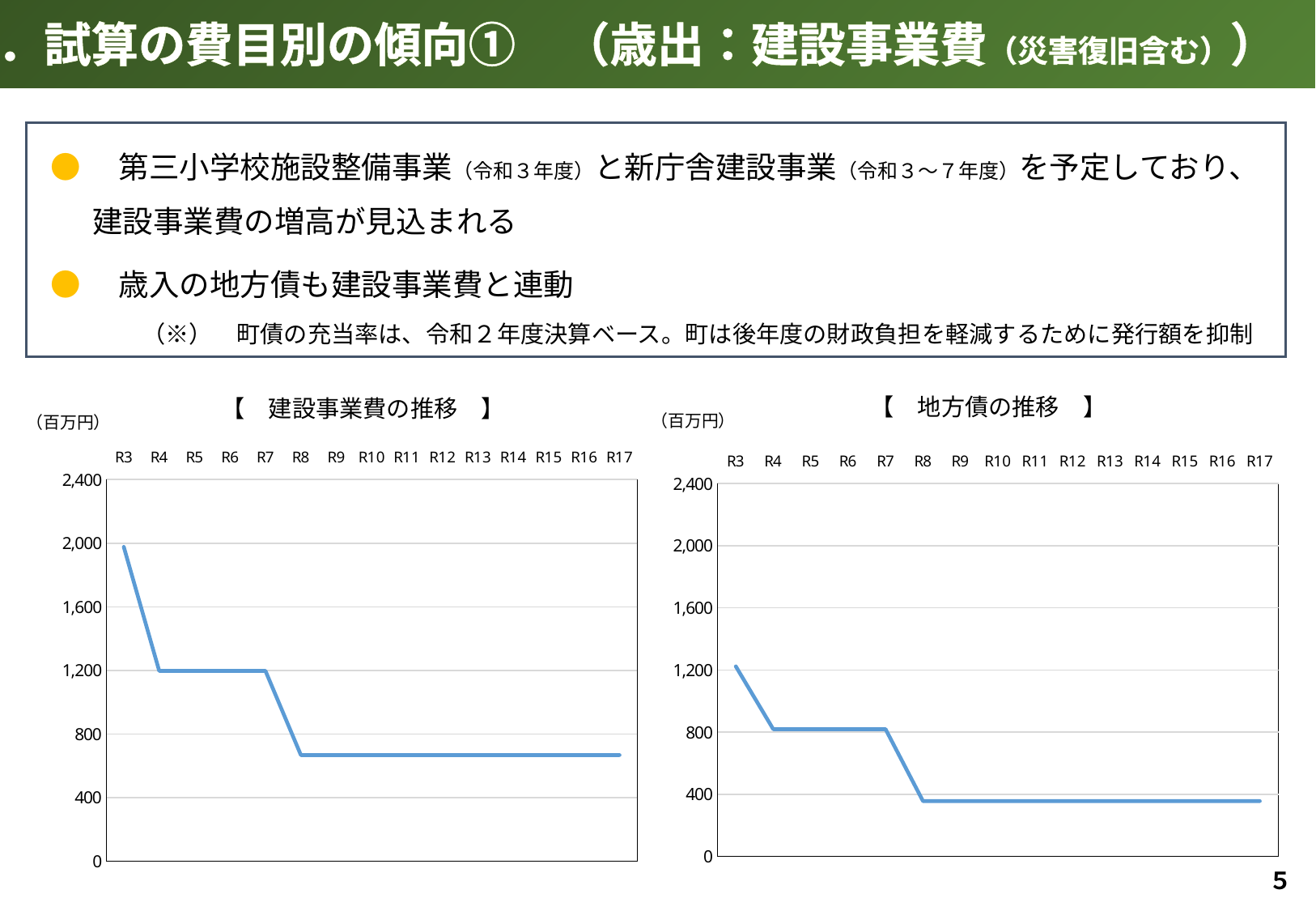
In the chart titled 地方債の推移, is the value for R3 greater or less than 800? greater What kind of chart is the chart titled 地方債の推移? line chart In the chart titled 建設事業費の推移, is the value for R5 greater or less than 800? greater In the chart titled 建設事業費の推移, is the value for R3 greater or less than 1,600? greater How many years are plotted on the x axis of the chart titled 建設事業費の推移? 15 In the chart titled 建設事業費の推移, which year has the highest value? R3 In the chart titled 地方債の推移, which is larger, the value for R6 or the value for R15? R6 In the chart titled 建設事業費の推移, do the values generally rise or fall from R3 to R17? fall In the chart titled 地方債の推移, which year has the highest value? R3 In the chart titled 建設事業費の推移, which is larger, the value for R3 or the value for R10? R3